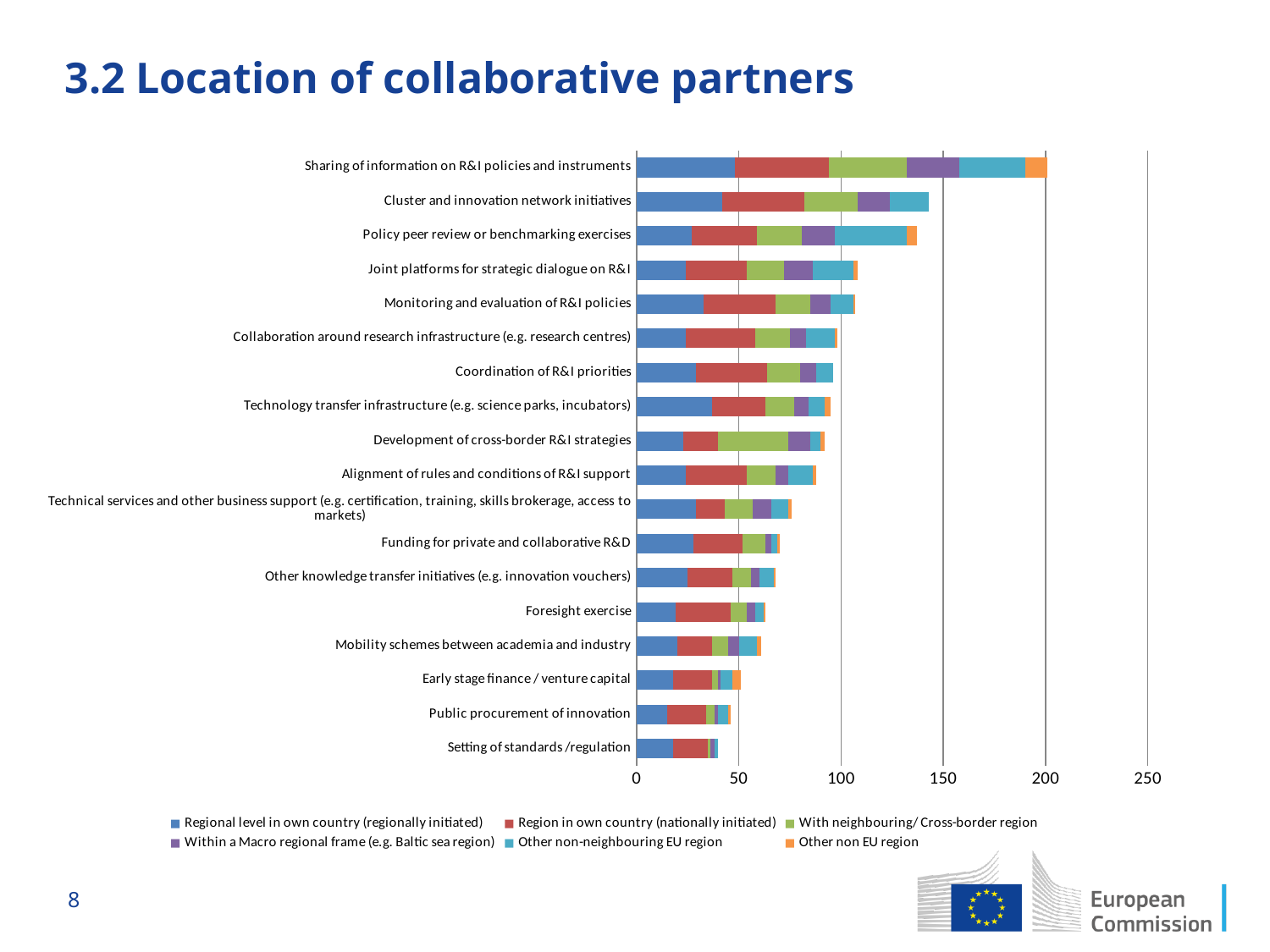
How many series does the legend list? 6 Which has the longer total bar: 'Sharing of information on R&I policies and instruments' or 'Cluster and innovation network initiatives'? Sharing of information on R&I policies and instruments Is the total bar for 'Sharing of information on R&I policies and instruments' greater or less than 150? greater Is the total bar for 'Setting of standards /regulation' greater or less than 50? less Which category has the longest total bar? Sharing of information on R&I policies and instruments Is the total bar for 'Cluster and innovation network initiatives' greater or less than 150? less Which legend entry is shown in orange? Other non EU region How many categories (collaboration activities) are plotted on the chart? 18 Do the total bar lengths increase or decrease going from the top category to the bottom category? decrease What kind of chart is shown on the slide? Stacked bar chart